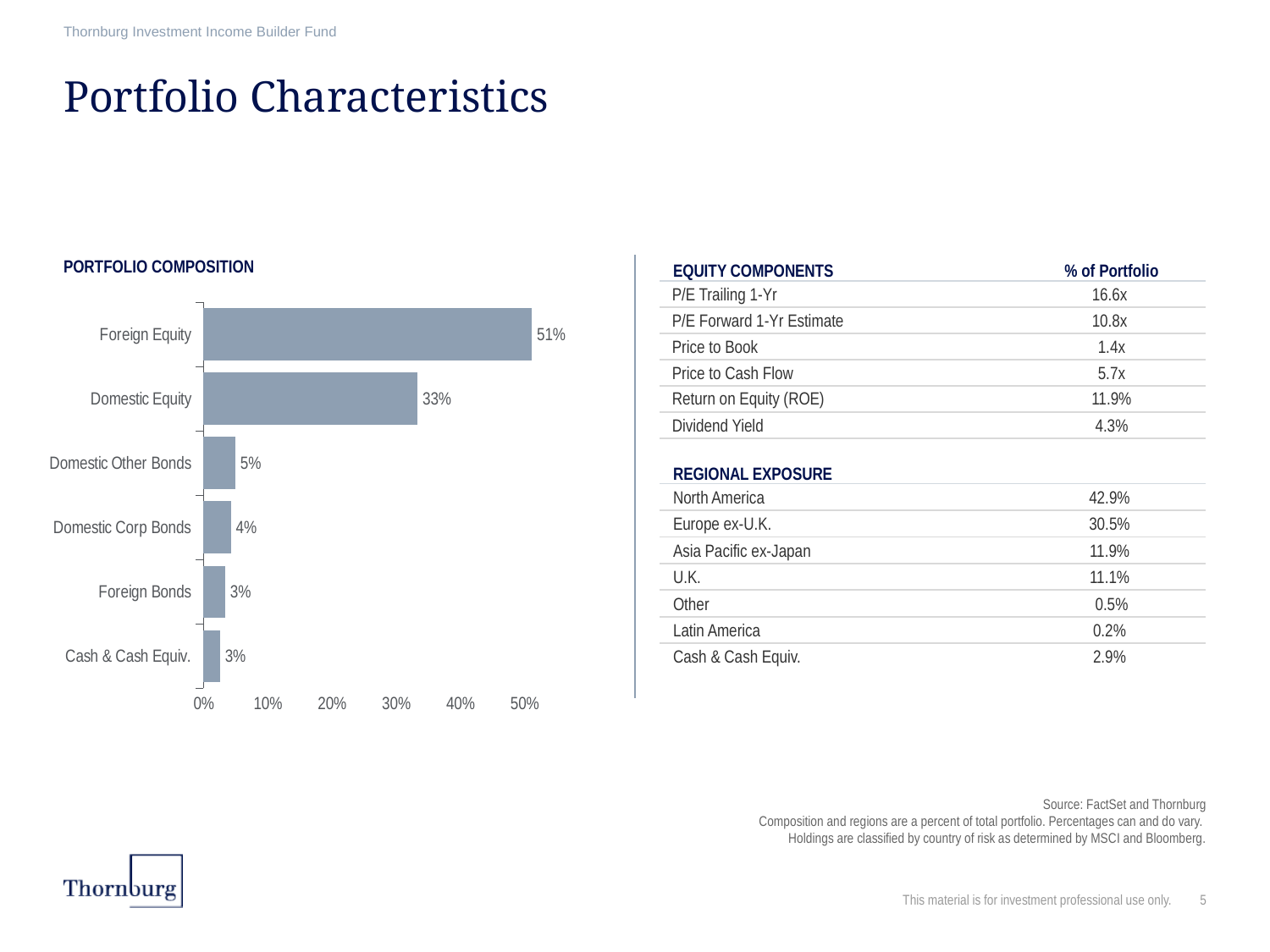
How many categories are shown in the Portfolio Composition chart? 6 Which category has the highest value in the Portfolio Composition chart? Foreign Equity Is the value for Domestic Equity in the Portfolio Composition chart greater or less than 30%? greater What is the difference between Foreign Equity and Domestic Equity in the Portfolio Composition chart? 18% What kind of chart is the Portfolio Composition chart? Bar chart Which is larger in the Portfolio Composition chart, Domestic Other Bonds or Domestic Corp Bonds? Domestic Other Bonds What is the value for Foreign Equity in the Portfolio Composition chart? 51% What is the value for Domestic Other Bonds in the Portfolio Composition chart? 5% What is the value for Domestic Equity in the Portfolio Composition chart? 33% What is the title of the chart on the slide? Portfolio Composition What is the value for Domestic Corp Bonds in the Portfolio Composition chart? 4% What is the highest tick label on the x axis of the Portfolio Composition chart? 50%